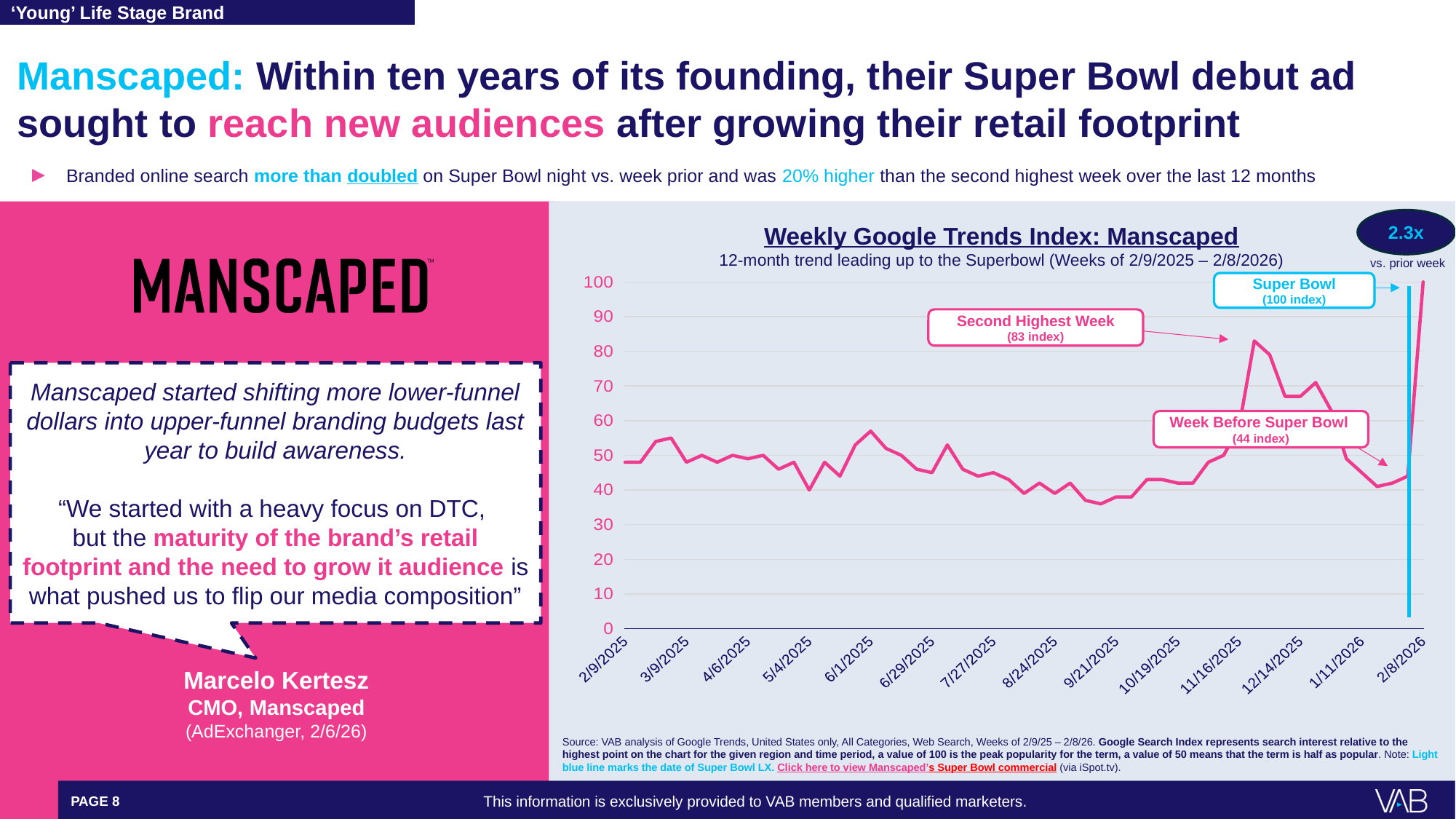
What is the Google Trends index value for the Super Bowl week? 100 Which is larger: the index for the Super Bowl week or the index for the second highest week? Super Bowl week Which week has the highest Google Trends index on the chart? Super Bowl week (2/8/2026) What does the light blue vertical line on the chart mark? The date of Super Bowl LX What type of chart is used to show the Weekly Google Trends Index for Manscaped? Line chart What is the difference between the Super Bowl week index and the second highest week index? 17 What is the difference between the Super Bowl week index and the week before Super Bowl index? 56 Is the index value for the week of 2/9/2025 greater or less than 40? greater What is the title of the chart? Weekly Google Trends Index: Manscaped What is the index value for the second highest week on the chart? 83 Does the index rise or fall from the week before the Super Bowl to the Super Bowl week? Rise What is the index value for the week before the Super Bowl? 44